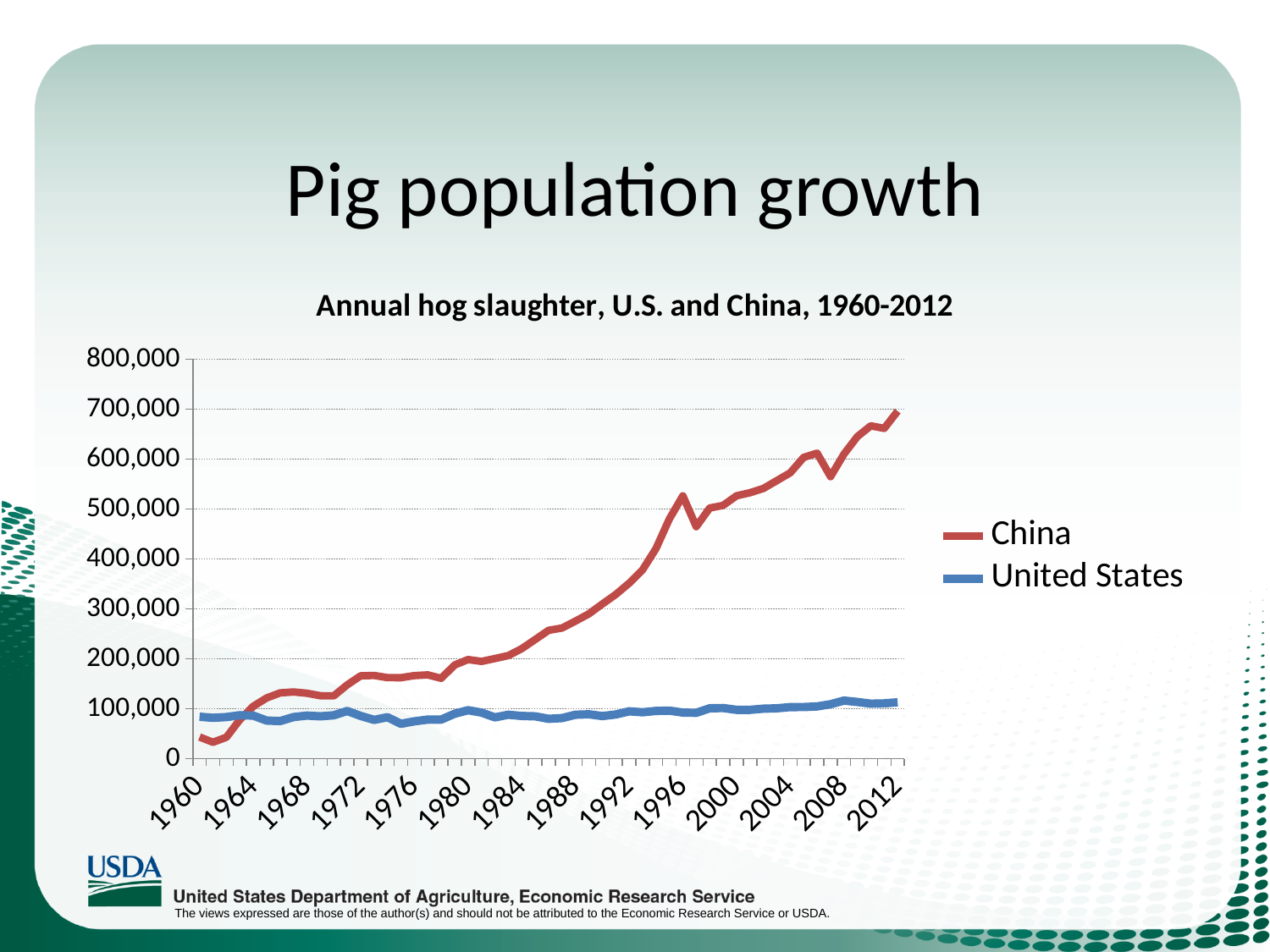
What kind of chart is shown on the slide? line chart Is the value for China in 2012 greater or less than 600,000? greater Is the value for China in 1988 greater or less than 200,000? greater Does the China series generally rise or fall from 1960 to 2012? rise Is the value for China in 2004 greater or less than 500,000? greater How many series does the legend list? 2 Which series has the higher value in 1960, China or United States? United States Which series is drawn in red? China Which series has the higher value in 2012, China or United States? China What is the title of the chart? Annual hog slaughter, U.S. and China, 1960-2012